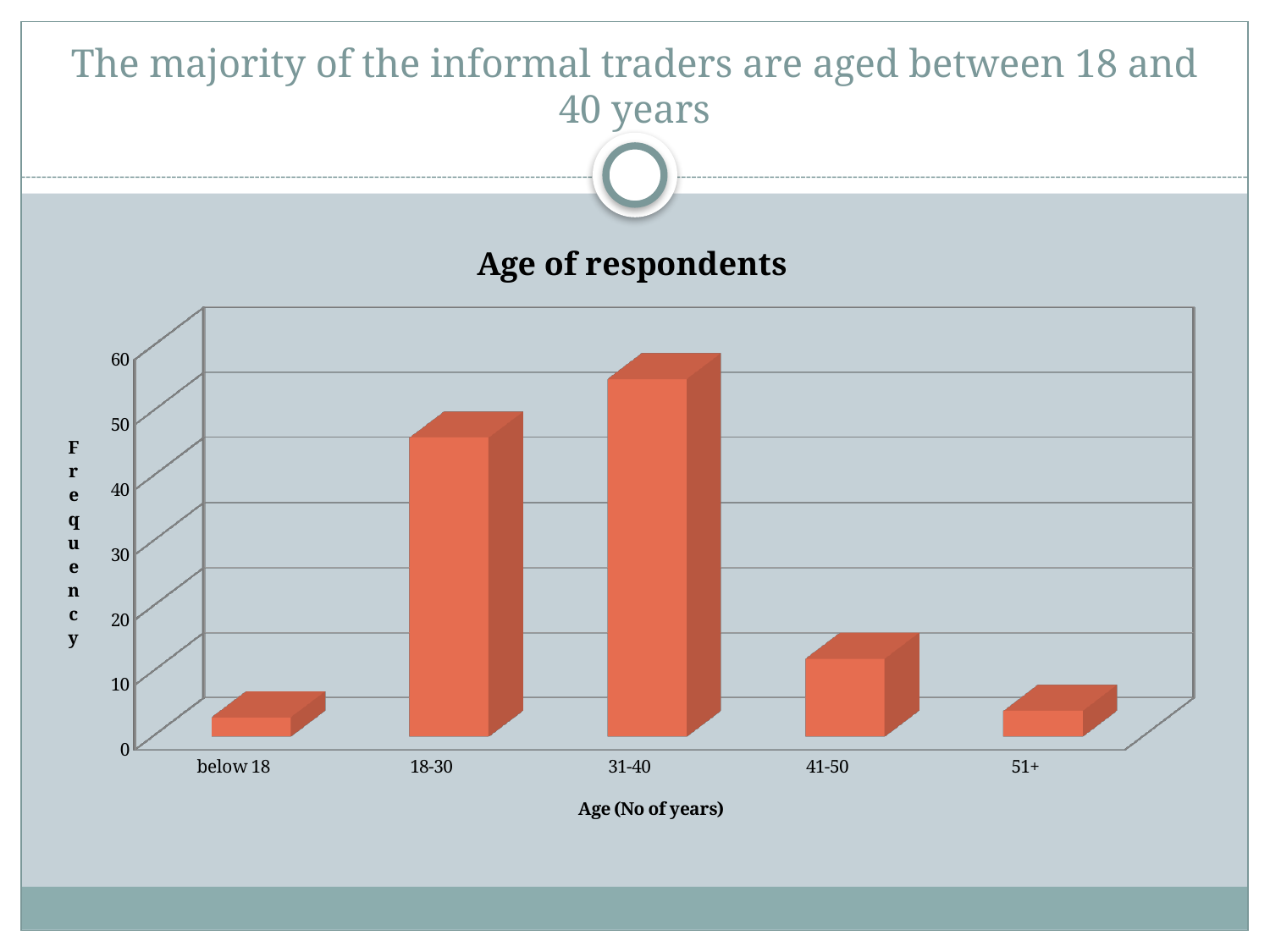
Is the frequency for the 18-30 age group greater or less than 40? greater Which has a higher frequency, the 18-30 group or the 41-50 group? 18-30 Which age category has the highest frequency? 31-40 What is the label of the x axis? Age (No of years) Is the frequency for the 31-40 age group greater or less than 50? greater Which has a higher frequency, the 31-40 group or the 18-30 group? 31-40 What kind of chart is shown on the slide? bar chart Is the frequency for the 51+ age group greater or less than 10? less How many age categories are shown on the x axis? 5 What is the title of the chart? Age of respondents